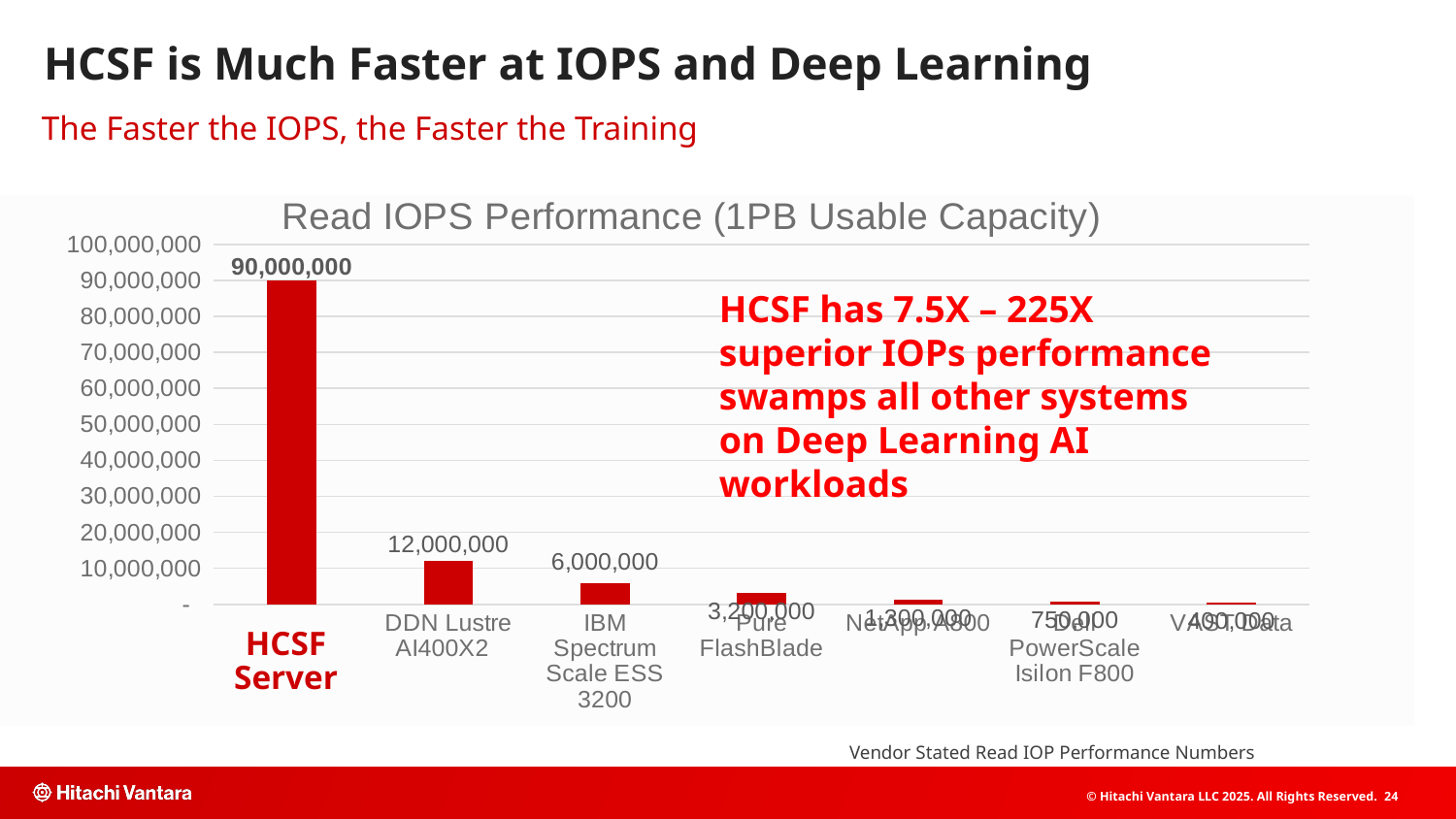
Which has a higher Read IOPS value, DDN Lustre AI400X2 or IBM Spectrum Scale ESS 3200? DDN Lustre AI400X2 How many systems are compared in the chart? 7 What is the title of the chart? Read IOPS Performance (1PB Usable Capacity) Is the Read IOPS value for HCSF Server greater or less than 80,000,000? greater What type of chart is shown on the slide? bar chart What is the Read IOPS value for DDN Lustre AI400X2? 12,000,000 Which system has the highest Read IOPS value? HCSF Server What is the Read IOPS value for Pure FlashBlade? 3,200,000 What is the Read IOPS value for IBM Spectrum Scale ESS 3200? 6,000,000 What is the Read IOPS value for HCSF Server? 90,000,000 What is the difference in Read IOPS between HCSF Server and DDN Lustre AI400X2? 78,000,000 Do the bar values rise or fall from left to right across the x axis? fall